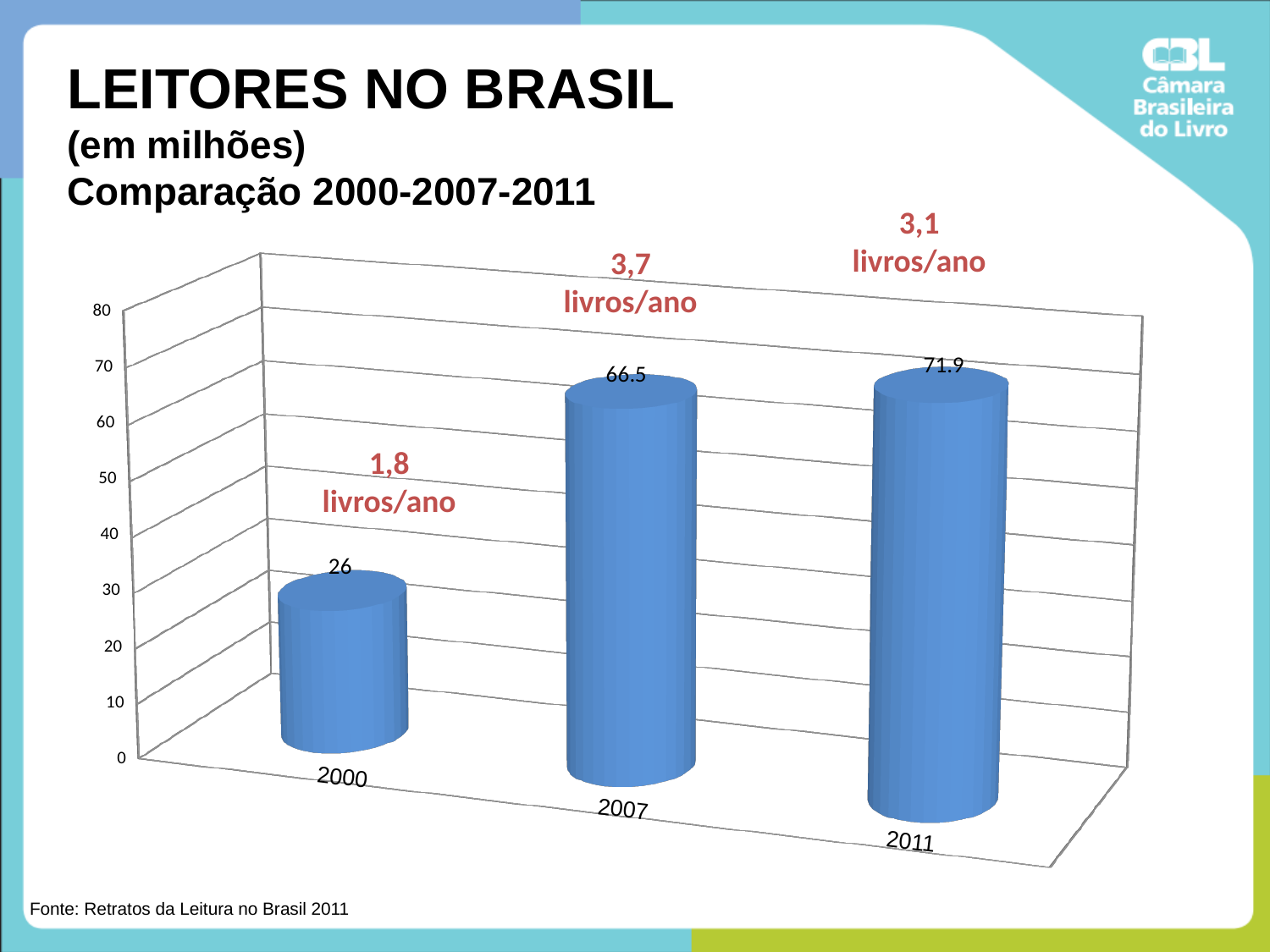
What is the annotation in red above the 2007 bar? 3,7 livros/ano Which year has the lowest value? 2000 What kind of chart is shown on the slide? Bar chart What is the value for 2007? 66.5 What is the difference between the values for 2007 and 2000? 40.5 What is the difference between the values for 2011 and 2007? 5.4 Which year has the highest value? 2011 How many years are shown on the x axis? 3 Do the values rise or fall from 2000 to 2011? Rise What is the value for 2011? 71.9 What is the value for 2000? 26 Which is larger, the value for 2007 or the value for 2000? 2007